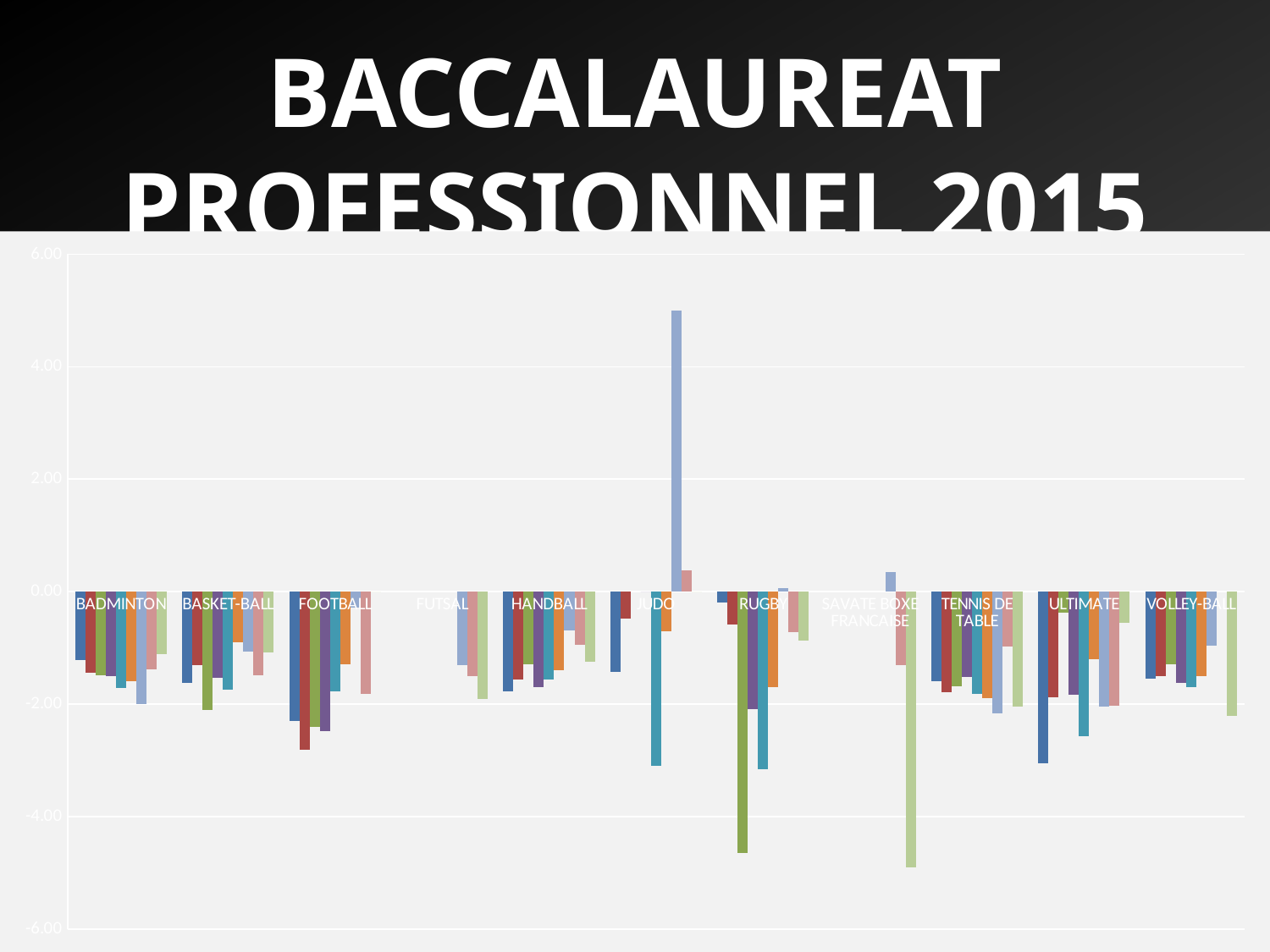
Which category contains the highest bar in the chart? JUDO Which category is the only one with a bar rising above 2.00? JUDO Is the lowest bar in the RUGBY category greater or less than -4.00? less What kind of chart is shown on the slide? bar chart Is the lowest bar in the ULTIMATE category greater or less than -2.00? less What is the title of the slide containing the chart? BACCALAUREAT PROFESSIONNEL 2015 Is the lowest bar in the HANDBALL category greater or less than -2.00? greater What are the minimum and maximum values shown on the chart's vertical axis? -6.00 and 6.00 How many sport categories are shown on the x axis of the chart? 11